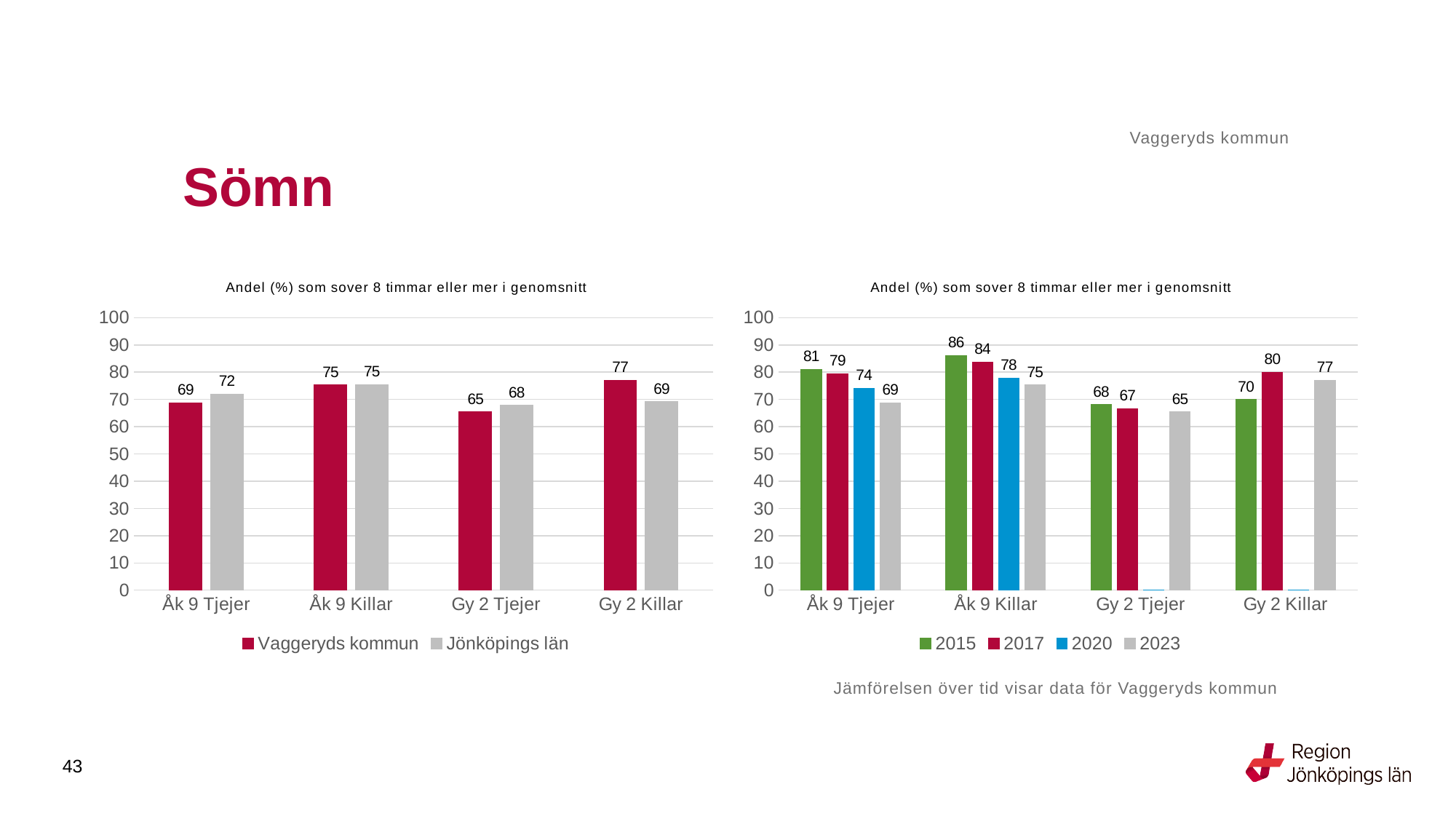
In the right chart, which category has the highest value for 2023? Gy 2 Killar In the right chart, what is the difference between 2015 and 2023 for Åk 9 Tjejer? 12 What kind of chart is the right chart? Bar chart In the right chart, what is the value for 2015 for Åk 9 Killar? 86 In the right chart, what is the value for 2020 for Åk 9 Tjejer? 74 In the right chart, how many series does the legend list? 4 In the left chart, which is larger for Gy 2 Killar: Vaggeryds kommun or Jönköpings län? Vaggeryds kommun In the left chart, how many series does the legend list? 2 In the left chart, what is the difference between Jönköpings län and Vaggeryds kommun for Åk 9 Tjejer? 3 In the left chart, what is the value for Vaggeryds kommun for Gy 2 Killar? 77 In the left chart, which category has the lowest value for Vaggeryds kommun? Gy 2 Tjejer In the left chart, what is the value for Jönköpings län for Åk 9 Tjejer? 72